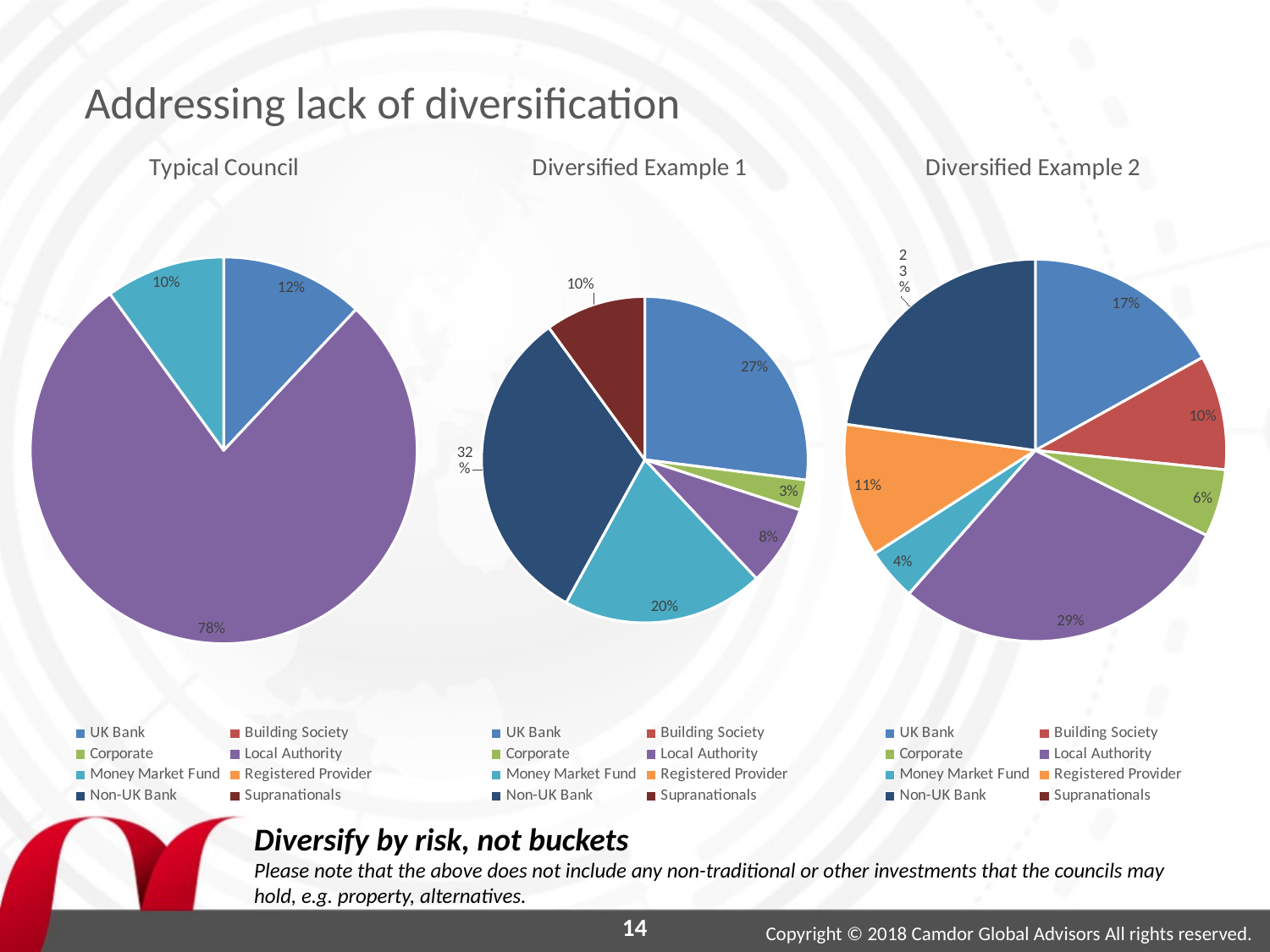
In the Diversified Example 1 pie chart, what is the difference between the UK Bank share and the Supranationals share? 17% In the Typical Council pie chart, what share does UK Bank have? 12% In the Typical Council pie chart, what share does Local Authority have? 78% In the Diversified Example 2 pie chart, what share does Registered Provider have? 11% How many entries does the legend under the Diversified Example 2 chart list? 8 In the Diversified Example 2 pie chart, which category has the smallest slice? Money Market Fund In the Diversified Example 1 pie chart, what share does Non-UK Bank have? 32% How many slices does the Typical Council pie chart have? 3 In the Diversified Example 2 pie chart, which is larger, the UK Bank slice or the Building Society slice? UK Bank In the Diversified Example 1 pie chart, what share does Money Market Fund have? 20% In the Diversified Example 2 pie chart, which category has the largest slice? Local Authority In the Diversified Example 1 pie chart, which category has the smallest slice? Corporate